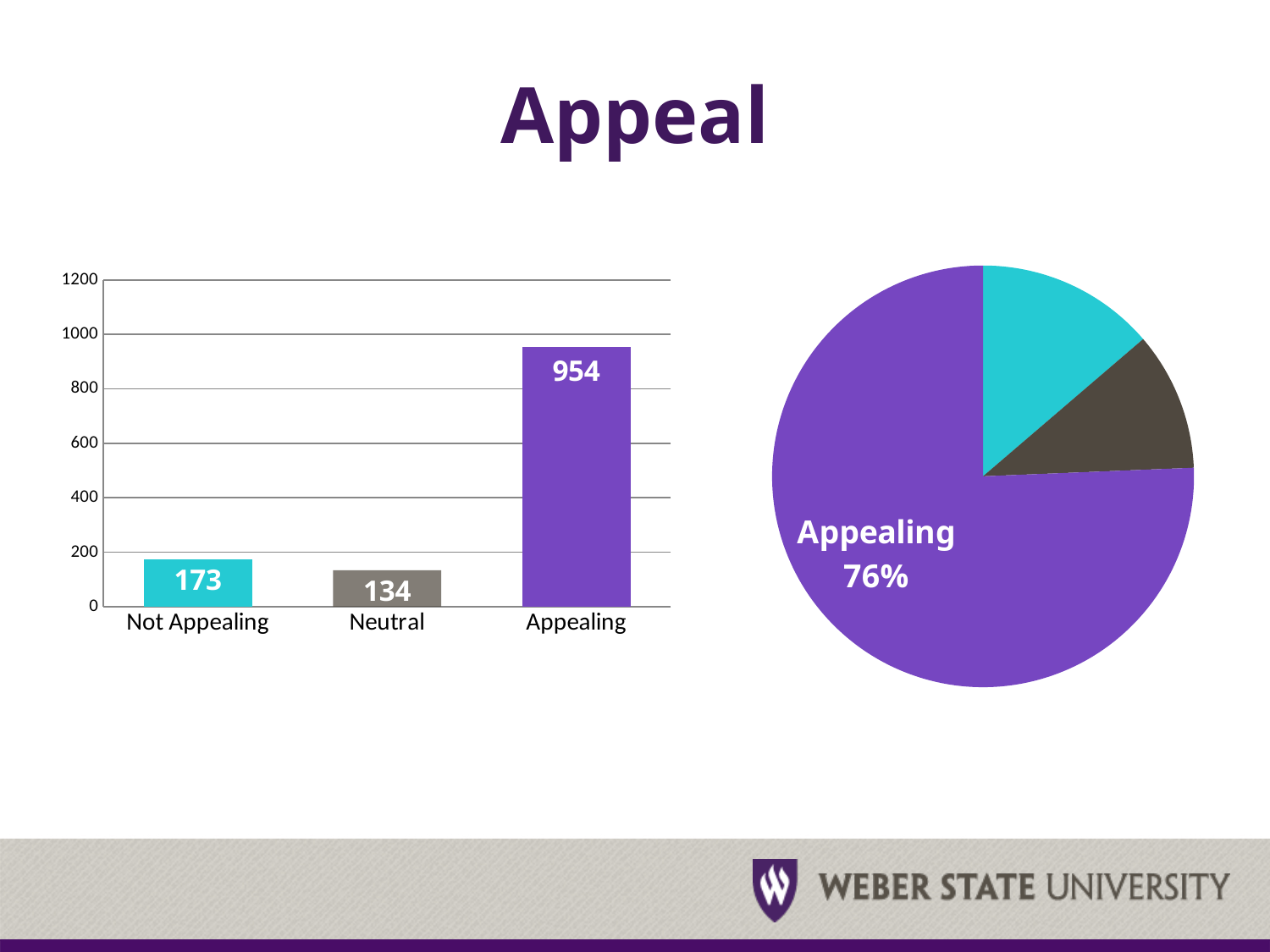
In the bar chart on the left, what is the difference between the Not Appealing and Neutral values? 39 In the bar chart on the left, which category has the lowest value? Neutral In the bar chart on the left, how many categories are shown? 3 In the pie chart on the right, what share does the Appealing slice have? 76% In the bar chart on the left, what is the difference between the Appealing and Not Appealing values? 781 In the bar chart on the left, which is larger, Not Appealing or Neutral? Not Appealing In the bar chart on the left, what is the value for Appealing? 954 What kind of chart is on the right side of the slide? Pie chart What kind of chart is on the left side of the slide? Bar chart In the bar chart on the left, what is the value for Neutral? 134 In the bar chart on the left, which category has the highest value? Appealing In the bar chart on the left, what is the value for Not Appealing? 173